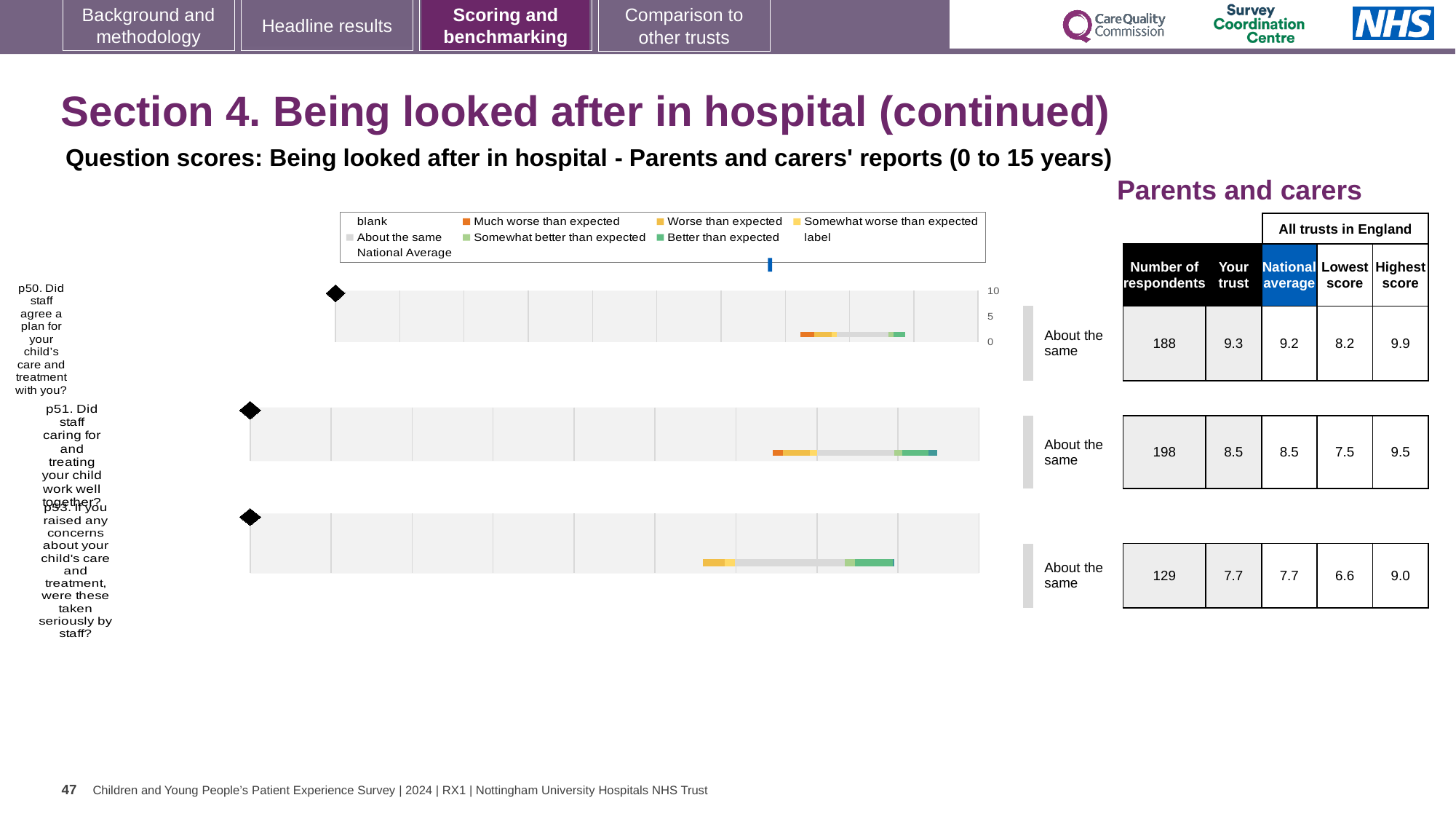
Which of the three questions has the lowest national average score? p53 What is the maximum value shown on the score axis of the charts? 10 What is the highest score across all trusts in England for question p50? 9.9 In the chart legend, which colour represents 'Much worse than expected'? orange How many survey questions (p50, p51, p53) are plotted as bars on this slide? 3 What is the number of respondents for question p51 (Did staff caring for and treating your child work well together?)? 198 What is the difference between the highest score (9.5) and the lowest score (7.5) for question p51? 2.0 What kind of chart is used to show the question scores on this slide? bar chart What is the 'Your trust' score for question p50 (Did staff agree a plan for your child's care and treatment with you?)? 9.3 For question p50, which is larger: the 'Your trust' score or the national average? Your trust Which of the three questions has the highest 'Your trust' score? p50 What is the lowest score across all trusts in England for question p53 (If you raised any concerns about your child's care and treatment, were these taken seriously by staff?)? 6.6